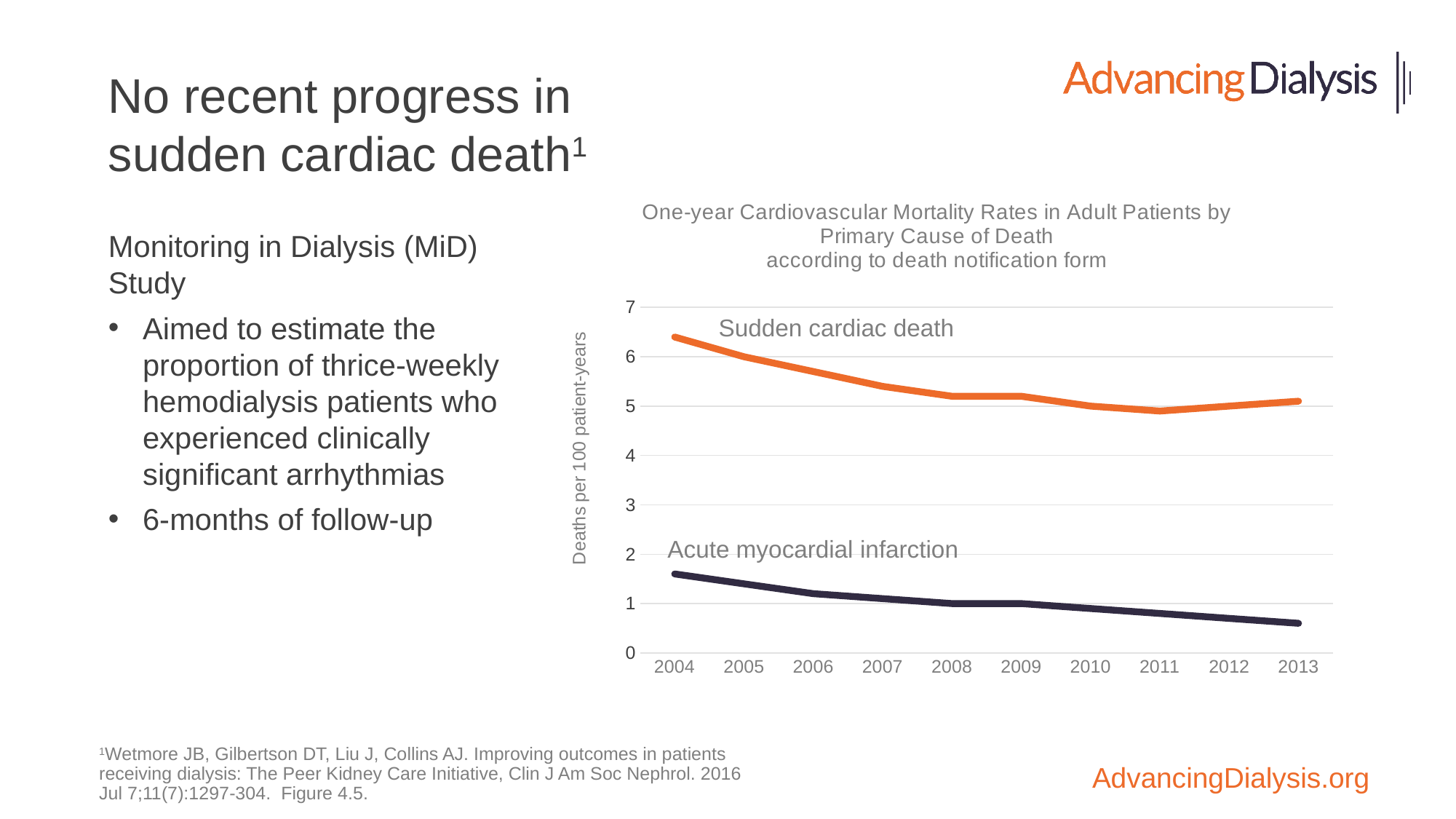
Is the value for Acute myocardial infarction in 2013 greater or less than 1? less Does the Acute myocardial infarction line rise or fall overall from 2004 to 2013? Fall Which year has the highest value for Sudden cardiac death? 2004 In 2010, which series has the larger value, Sudden cardiac death or Acute myocardial infarction? Sudden cardiac death Which year has the highest value for Acute myocardial infarction? 2004 Which year has the lowest value for Acute myocardial infarction? 2013 Is the value for Sudden cardiac death in 2004 greater or less than 6? greater How many series are plotted on the chart? 2 How many years are shown along the x axis of the chart? 10 What kind of chart is shown on the slide? Line chart Is the value for Acute myocardial infarction in 2004 greater or less than 1? greater What is the label on the vertical axis of the chart? Deaths per 100 patient-years